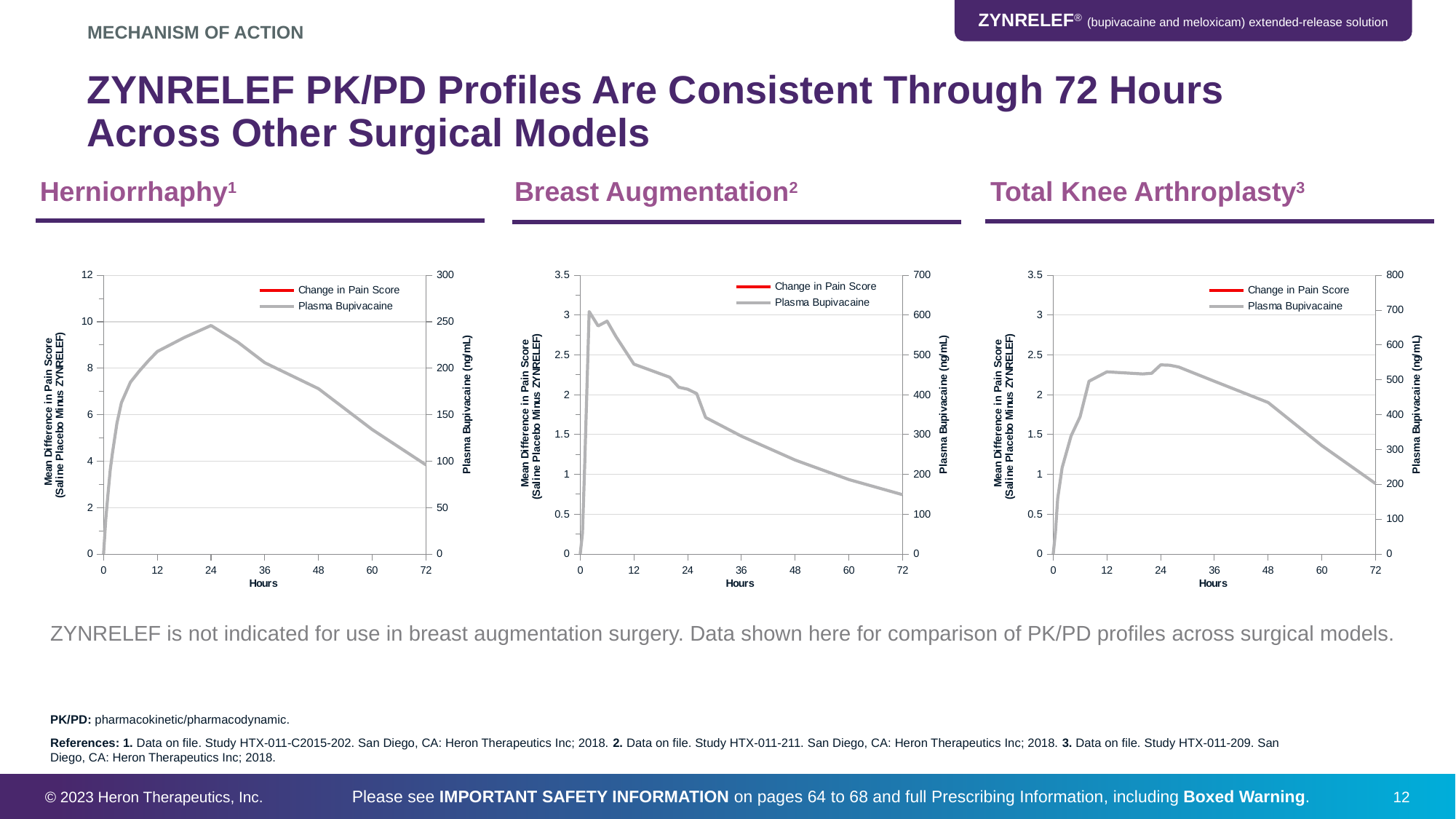
What kind of chart is the Herniorrhaphy chart? Line chart In the Total Knee Arthroplasty chart, does the Plasma Bupivacaine line rise or fall between 0 and 12 hours? Rise In the Total Knee Arthroplasty chart, is the Plasma Bupivacaine value at 24 hours greater or less than 500? greater What is the last value shown on the Hours axis of the Breast Augmentation chart? 72 In the Herniorrhaphy chart, does the Plasma Bupivacaine line rise or fall between 24 and 72 hours? Fall How many series does the legend of the Breast Augmentation chart list? 2 In the Herniorrhaphy chart, is the Plasma Bupivacaine value at 48 hours greater or less than 150? greater In the Total Knee Arthroplasty chart, is the Plasma Bupivacaine value at 72 hours greater or less than 300? less In the Total Knee Arthroplasty chart, what are the two series named in the legend? Change in Pain Score and Plasma Bupivacaine